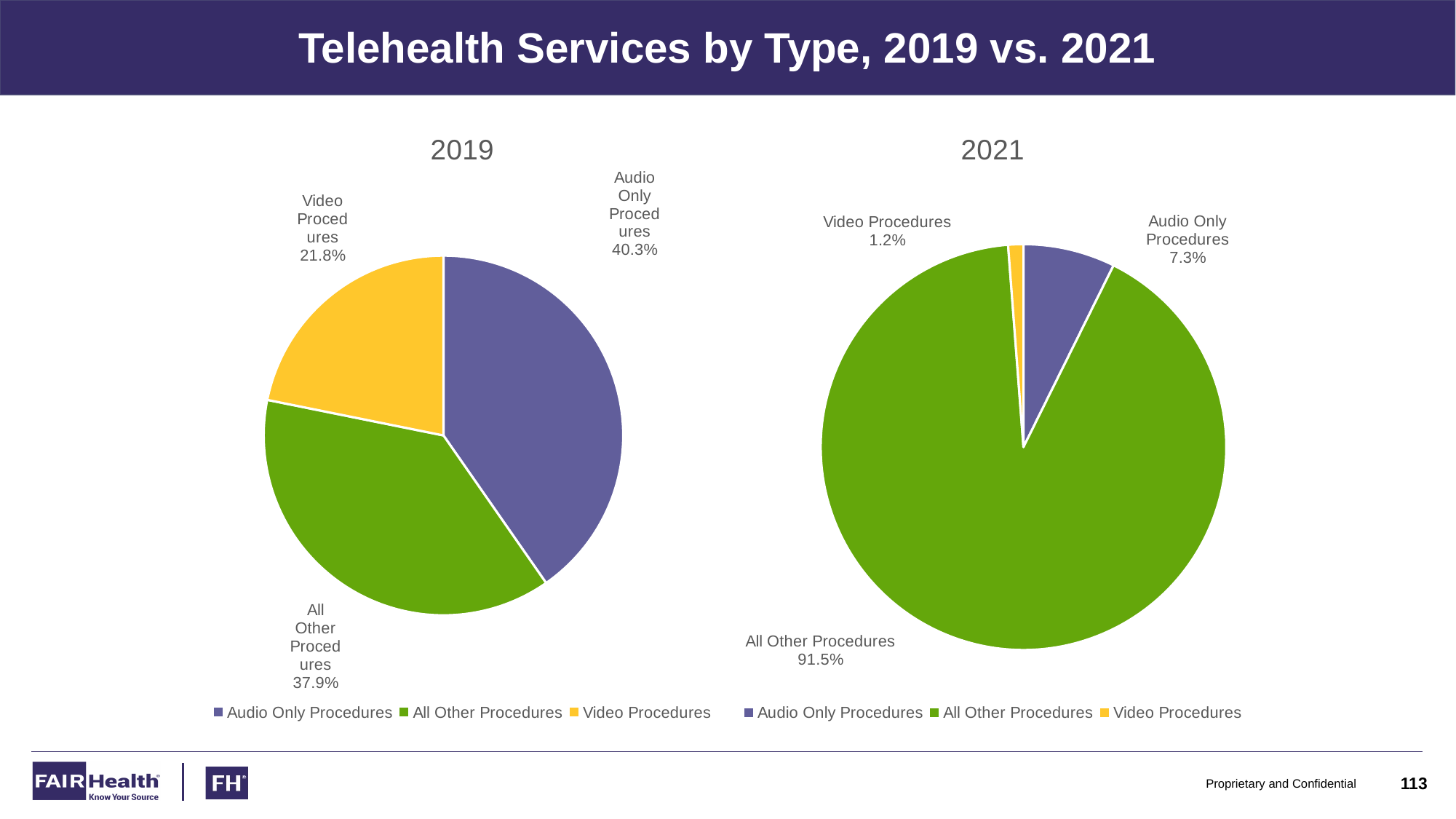
What kind of chart is used for the 2021 data? pie chart In the 2021 pie chart, is the share for Audio Only Procedures larger or smaller than the share for Video Procedures? larger How many categories does the legend of the 2019 chart list? 3 In the 2019 pie chart, which category has the largest share? Audio Only Procedures In the 2019 pie chart, what share do All Other Procedures have? 37.9% In the 2019 pie chart, what share do Video Procedures have? 21.8% In the 2019 pie chart, what is the difference in percentage points between Audio Only Procedures and Video Procedures? 18.5 In the 2021 pie chart, what share do All Other Procedures have? 91.5% In the 2021 pie chart, which category has the smallest share? Video Procedures